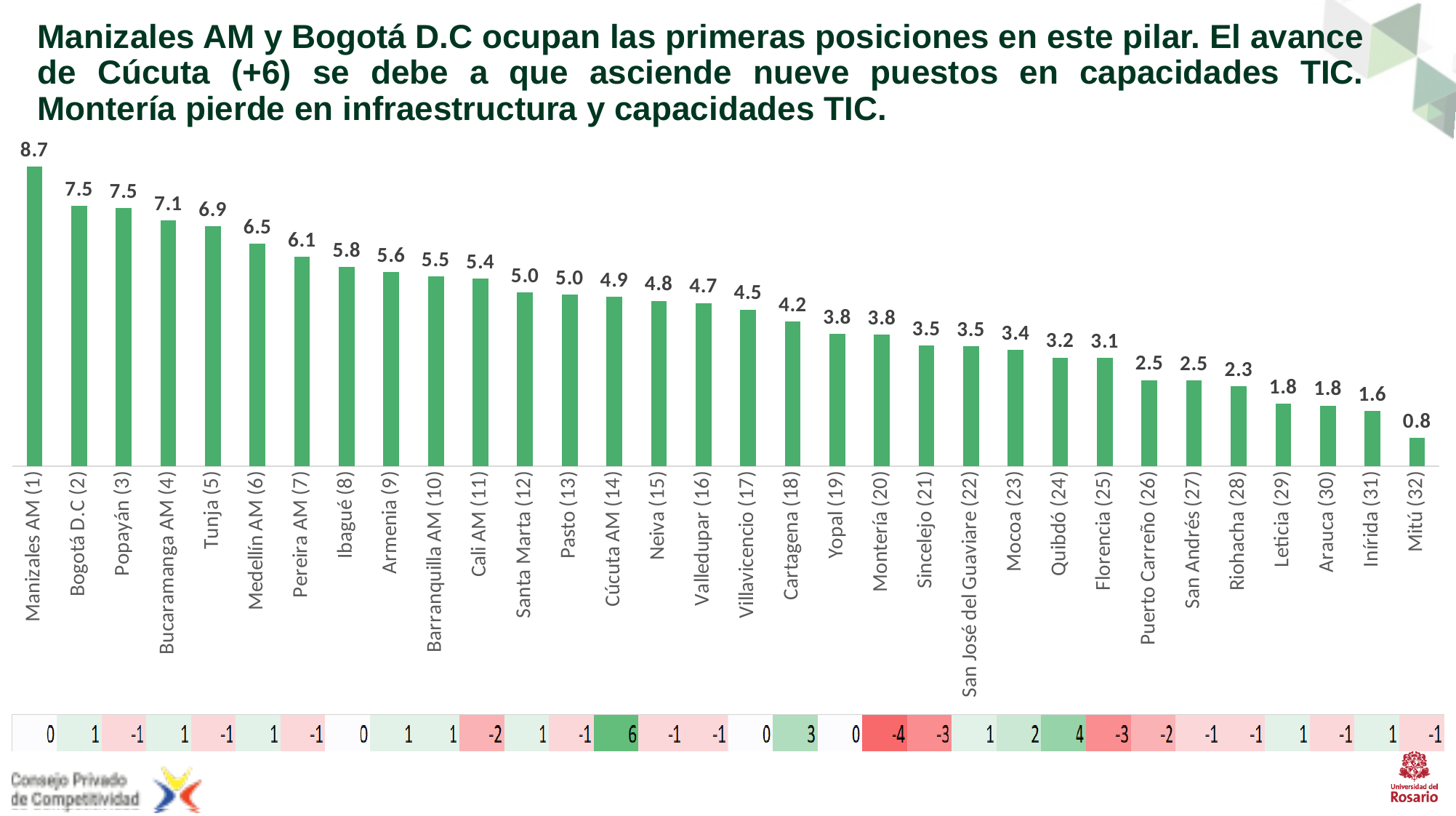
Which has a larger value, Tunja (5) or Medellín AM (6)? Tunja (5) What is the difference between the values for Manizales AM (1) and Bogotá D.C (2)? 1.2 What is the value for Cúcuta AM (14)? 4.9 Which city has the lowest value? Mitú (32) What colour are the bars in the chart? Green What is the value for Manizales AM (1)? 8.7 What is the value for Montería (20)? 3.8 How many cities are shown in the bar chart? 32 What is the difference between the values for Cali AM (11) and Santa Marta (12)? 0.4 What kind of chart is shown on the slide? Bar chart Do the values rise or fall from left to right along the x axis? Fall Which city has the highest value? Manizales AM (1)